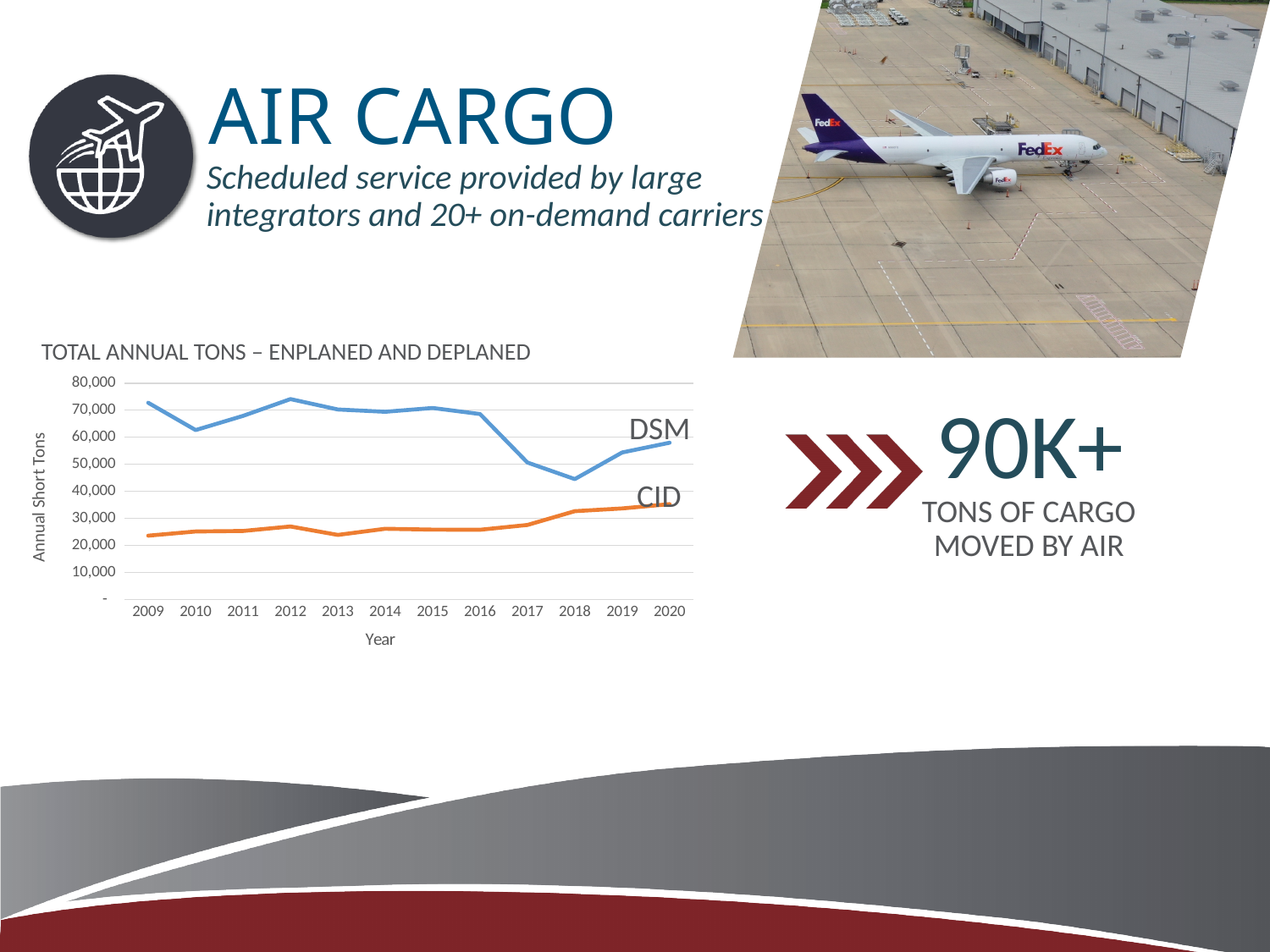
Is the CID value for 2020 greater or less than 30,000? greater In which year is the DSM series at its lowest? 2018 What is the label on the vertical axis of the chart? Annual Short Tons What kind of chart is shown on the slide? Line chart Does the DSM series rise or fall between 2016 and 2018? Fall Is the DSM value for 2018 greater or less than 50,000? less Which series has the larger value in 2015, DSM or CID? DSM Is the DSM value for 2009 greater or less than 70,000? greater How many years are plotted along the x axis of the chart? 12 How many series are plotted in the chart? 2 What is the title of the chart? TOTAL ANNUAL TONS – ENPLANED AND DEPLANED In which year is the CID series at its highest? 2020